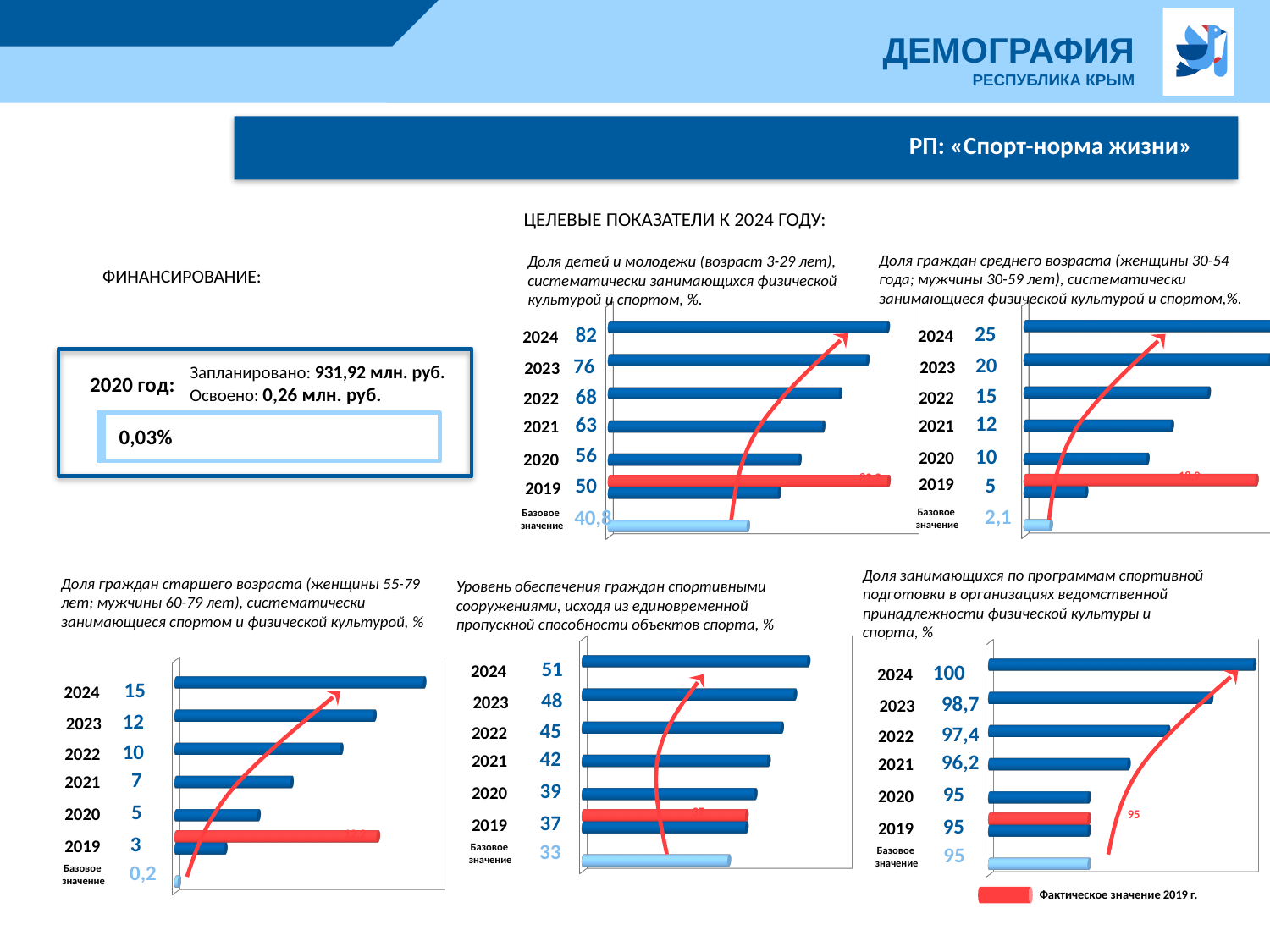
On the chart 'Доля детей и молодежи (возраст 3-29 лет)...', what is the target value for 2024? 82 On the chart 'Доля граждан старшего возраста...', what is the value for 2021? 7 On the chart 'Уровень обеспечения граждан спортивными сооружениями...', what is the value for 2020? 39 On the chart 'Уровень обеспечения граждан спортивными сооружениями...', how much higher is the 2024 value than the базовое значение? 18 On the chart 'Доля занимающихся по программам спортивной подготовки...', what is the value for 2023? 98,7 On the chart 'Доля граждан старшего возраста...', which year has the lowest target value? 2019 On the chart 'Доля детей и молодежи (возраст 3-29 лет)...', what is the базовое значение (baseline value)? 40,8 What type of chart is used for 'Уровень обеспечения граждан спортивными сооружениями...'? bar chart On the chart 'Доля детей и молодежи (возраст 3-29 лет)...', do the target values rise or fall from 2019 to 2024? rise On the chart 'Доля граждан среднего возраста...', what is the difference between the 2024 value and the 2019 value? 20 On the chart 'Доля занимающихся по программам спортивной подготовки...', which is larger: the value for 2022 or the value for 2021? 2022 On the chart 'Доля граждан среднего возраста...', what is the value for 2022? 15